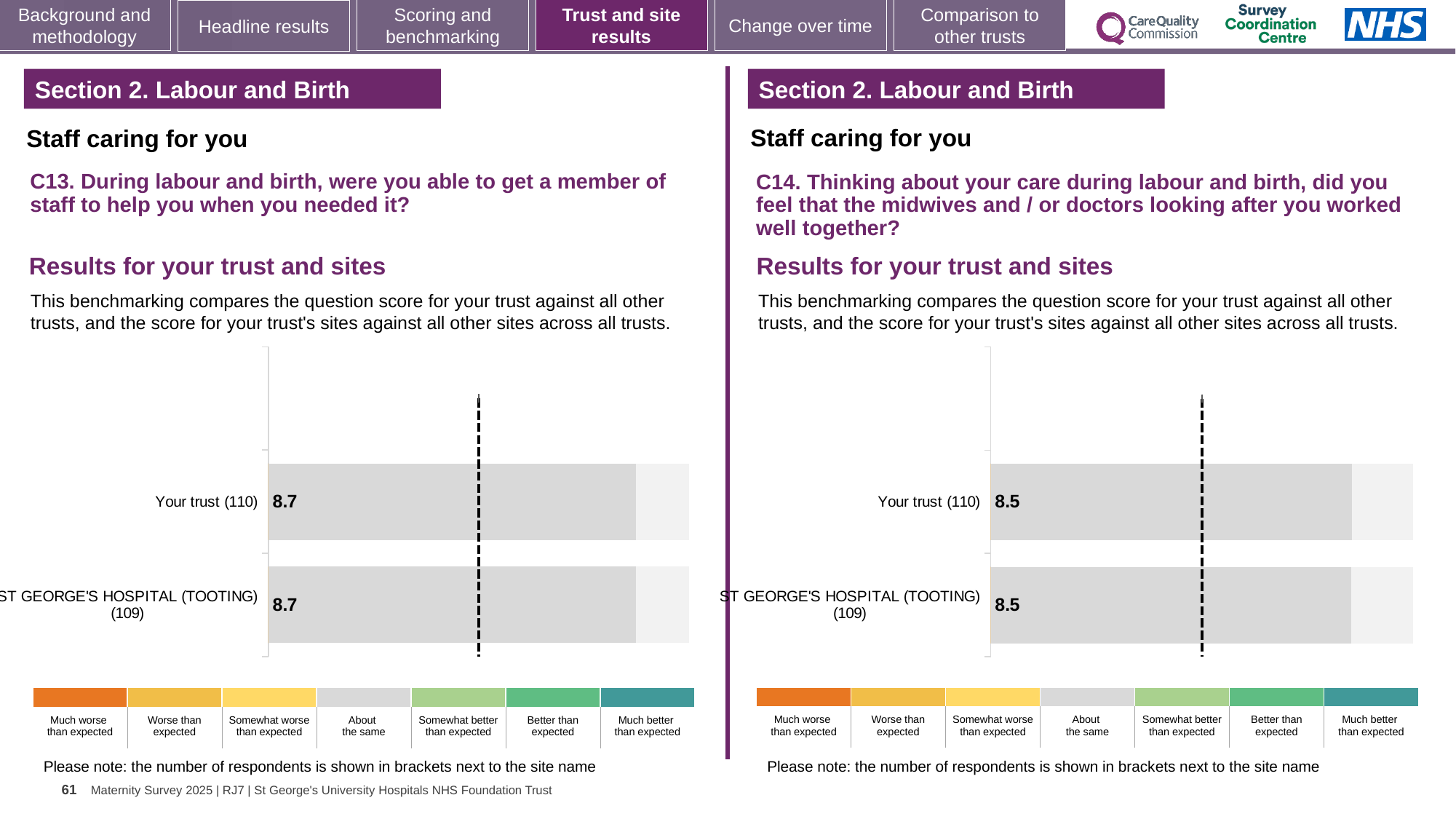
In the C13 chart on the left, what is the score for St George's Hospital (Tooting)? 8.7 In the C14 chart on the right, what is the score for Your trust? 8.5 In the C14 chart on the right, what is the difference between the score for Your trust and the score for St George's Hospital (Tooting)? 0 In the C14 chart on the right, how many respondents are shown in brackets for St George's Hospital (Tooting)? 109 How many benchmark categories are listed in the colour key below the C13 chart on the left? 7 What type of chart is used in the C13 chart on the left? Bar chart How many bars are plotted in the C14 chart on the right? 2 In the C13 chart on the left, how many respondents are shown in brackets for Your trust? 110 How many bars are plotted in the C13 chart on the left? 2 In the C14 chart on the right, what is the score for St George's Hospital (Tooting)? 8.5 In the C13 chart on the left, what is the score for Your trust? 8.7 In the C13 chart on the left, what is the difference between the score for Your trust and the score for St George's Hospital (Tooting)? 0